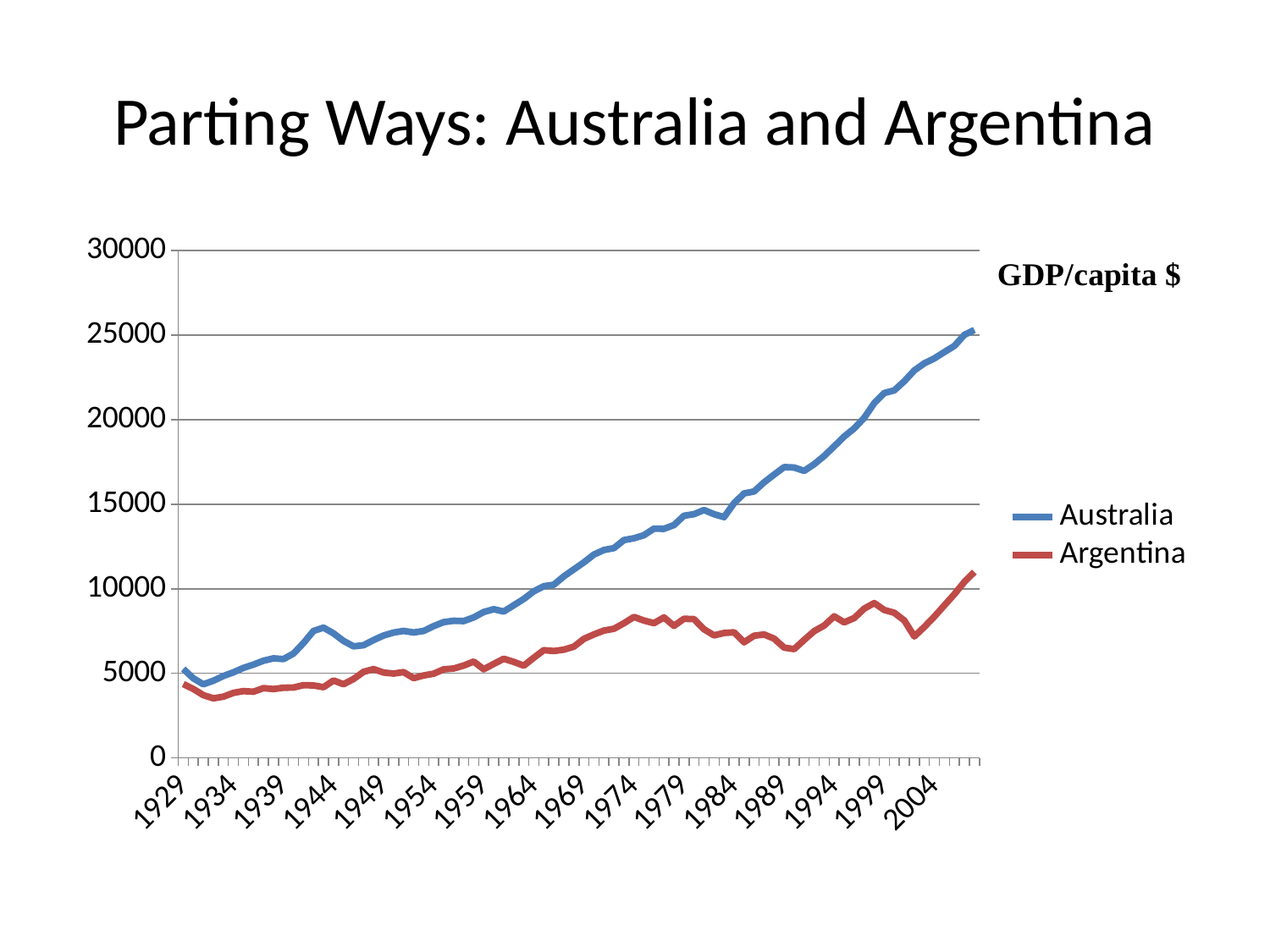
Which series has the higher value in 1969, Australia or Argentina? Australia Which series reaches the highest value on the chart? Australia Is the value for Argentina in 2004 greater or less than 10000? less Is the value for Australia in 2004 greater or less than 20000? greater Does the Australia line generally rise or fall from 1929 to the end of the series? rise Is the value for Australia in 1969 greater or less than 10000? greater Which two series are listed in the chart legend? Australia and Argentina How many series does the legend list? 2 What kind of chart is shown on the slide? line chart What colour is the Australia line in the chart? blue Which series has the higher value in 1999, Australia or Argentina? Australia